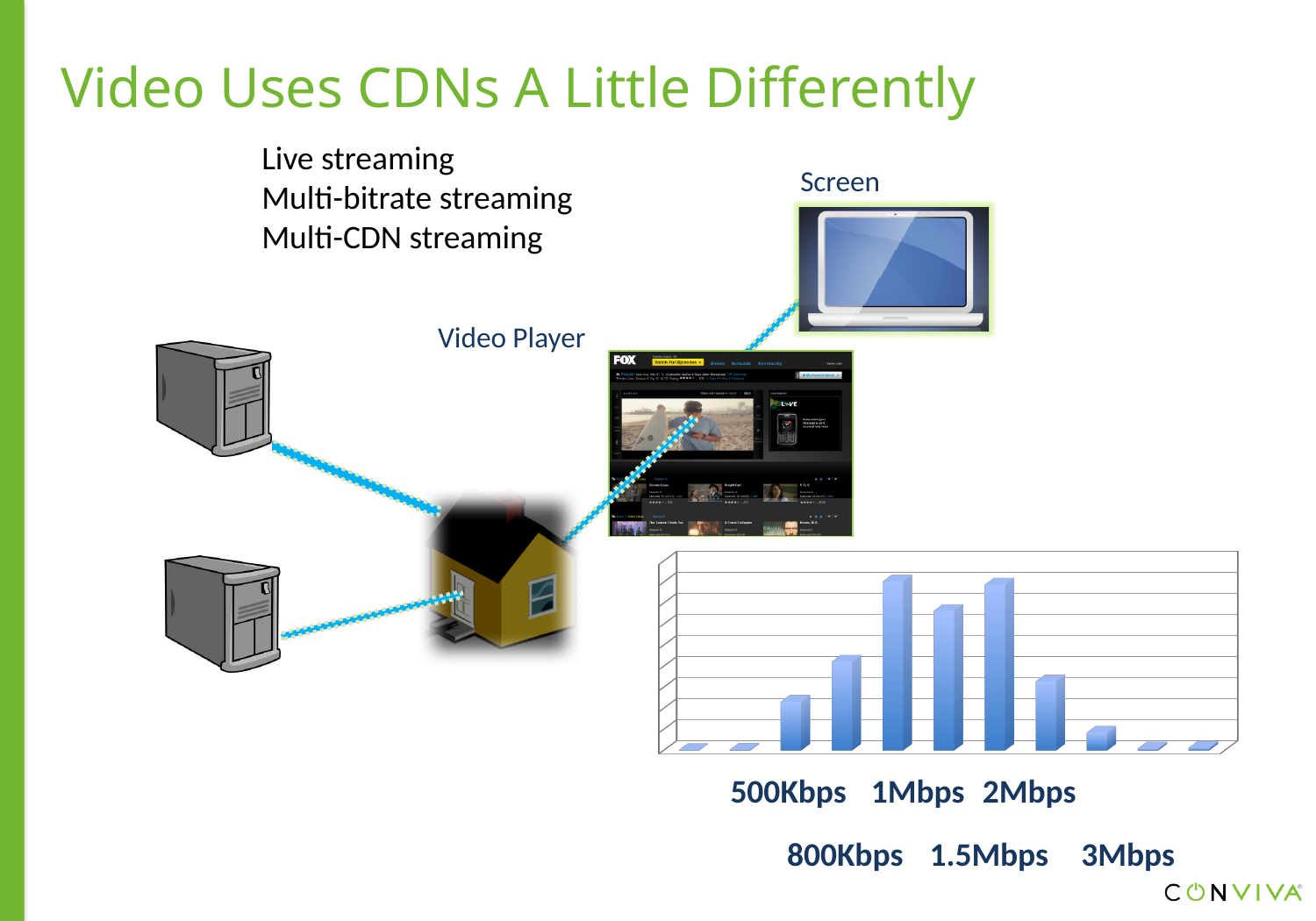
Does the chart show a legend? no What kind of chart is shown at the bottom right of the slide? bar chart What colour are the bars in the chart? blue Which bitrate labels are printed below the chart? 500Kbps, 800Kbps, 1Mbps, 1.5Mbps, 2Mbps, 3Mbps Do the bar heights rise or fall moving from the leftmost bar toward the middle of the chart? rise Do the bar heights rise or fall moving from the middle of the chart toward the rightmost bar? fall